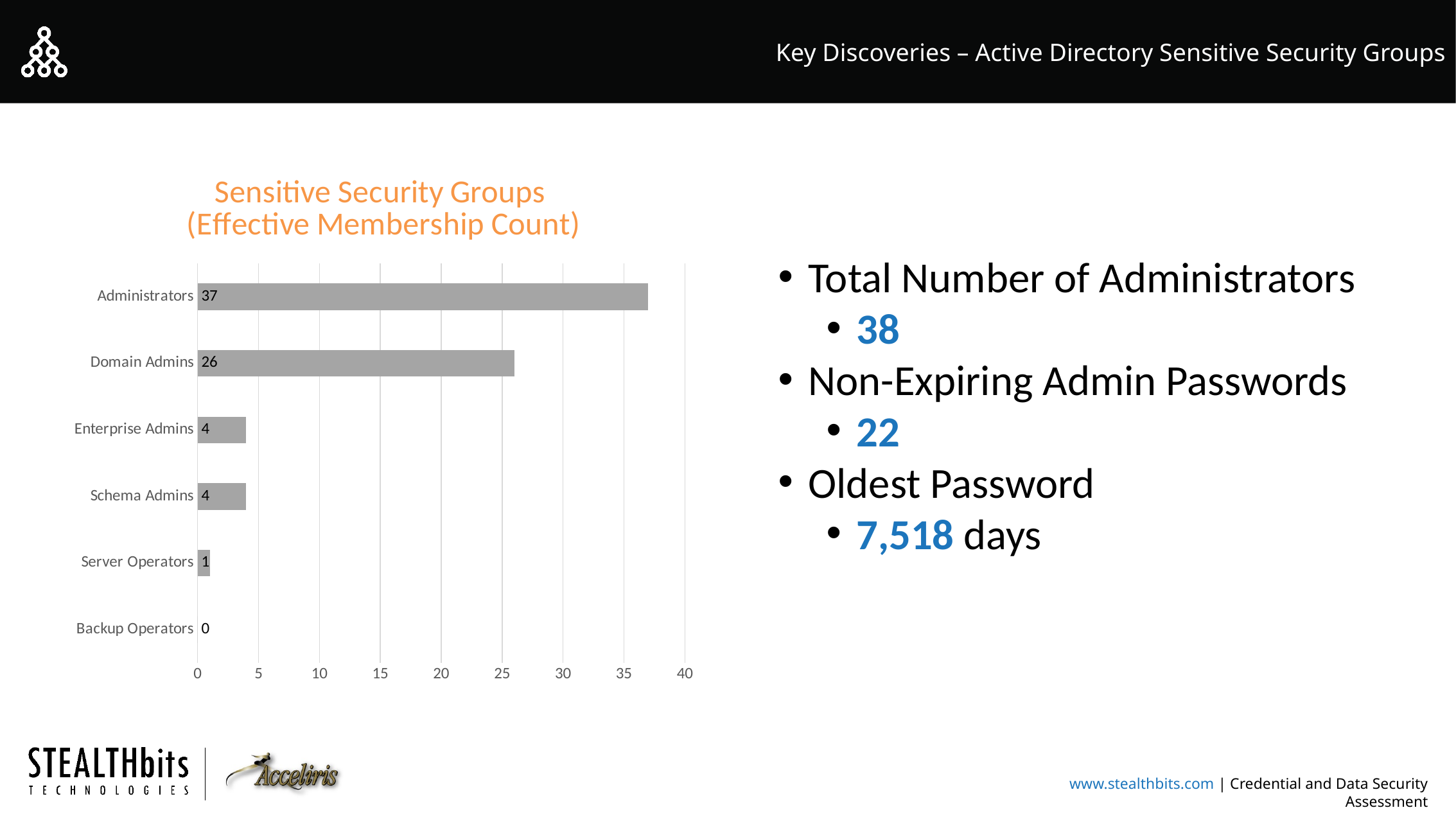
Is the value for Domain Admins greater or less than 25? greater Which has a larger membership count, Domain Admins or Enterprise Admins? Domain Admins What kind of chart is shown on the slide? Bar chart Which group has the lowest effective membership count? Backup Operators What is the title of the chart? Sensitive Security Groups (Effective Membership Count) How many groups are shown in the chart? 6 What is the effective membership count for Domain Admins? 26 What is the effective membership count for Backup Operators? 0 What is the effective membership count for Server Operators? 1 Which group has the highest effective membership count? Administrators What is the effective membership count for Administrators? 37 What is the difference between the membership counts of Administrators and Domain Admins? 11